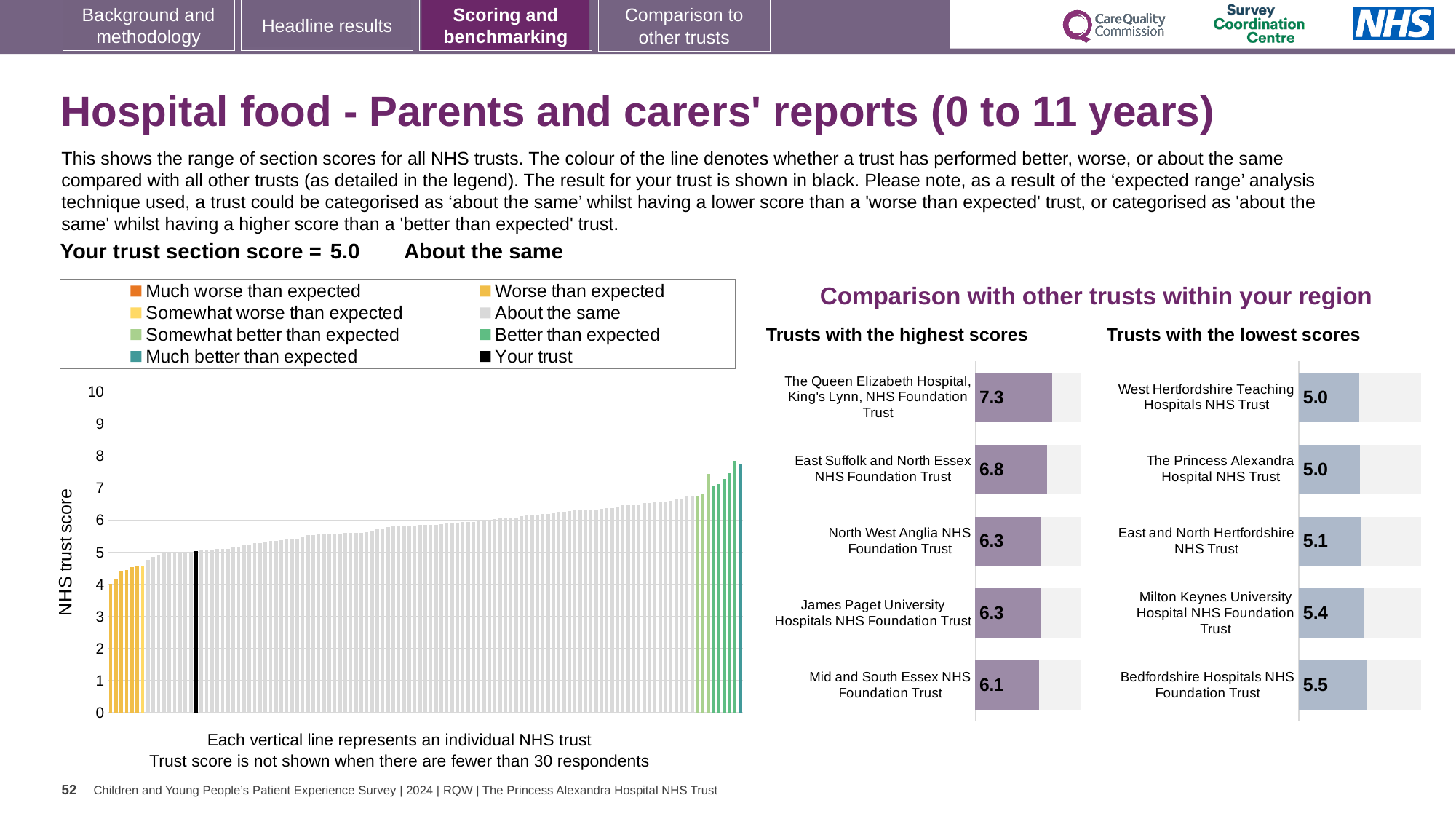
In the 'Trusts with the highest scores' chart, what is the difference between the scores of The Queen Elizabeth Hospital, King's Lynn and East Suffolk and North Essex? 0.5 In the 'Trusts with the highest scores' chart, what is the score for East Suffolk and North Essex NHS Foundation Trust? 6.8 What kind of chart is the large chart on the left showing NHS trust scores? Bar chart In the 'Trusts with the highest scores' chart, what is the score for The Queen Elizabeth Hospital, King's Lynn, NHS Foundation Trust? 7.3 In the large chart on the left, do the trust scores rise or fall from left to right? Rise In the 'Trusts with the lowest scores' chart, what is the score for Milton Keynes University Hospital NHS Foundation Trust? 5.4 In the 'Trusts with the highest scores' chart, how many trusts are shown? 5 How many entries does the legend above the large chart on the left list? 8 In the 'Trusts with the lowest scores' chart, which trust has the highest score? Bedfordshire Hospitals NHS Foundation Trust In the 'Trusts with the lowest scores' chart, which has the larger score: East and North Hertfordshire NHS Trust or Milton Keynes University Hospital NHS Foundation Trust? Milton Keynes University Hospital NHS Foundation Trust In the 'Trusts with the lowest scores' chart, what is the difference between the scores of Bedfordshire Hospitals NHS Foundation Trust and West Hertfordshire Teaching Hospitals NHS Trust? 0.5 In the 'Trusts with the highest scores' chart, which trust has the lowest score? Mid and South Essex NHS Foundation Trust